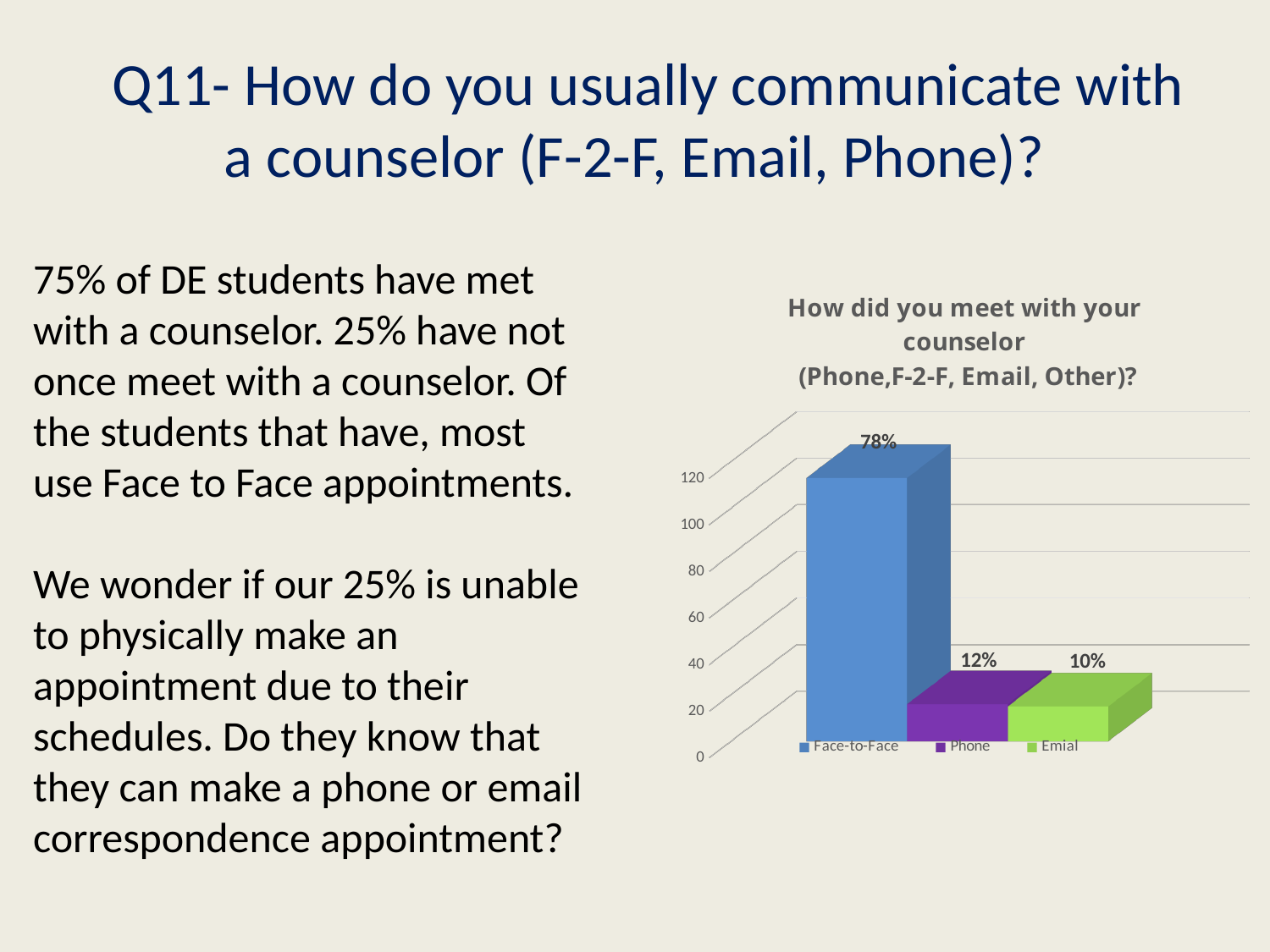
How many entries does the legend list? 3 Which is larger, the value for Phone or the value for Email? Phone Which category has the highest value? Face-to-Face What is the difference between the Phone value and the Email value? 2% What is the value for Phone? 12% What is the value for Face-to-Face? 78% Which category has the lowest value? Emial How many bars are plotted in the chart? 3 What is the value for the Email (labelled "Emial") bar? 10% What is the difference between the Face-to-Face value and the Phone value? 66% Is the value for Face-to-Face greater or less than 60 on the axis? greater What kind of chart is shown on the slide? Bar chart